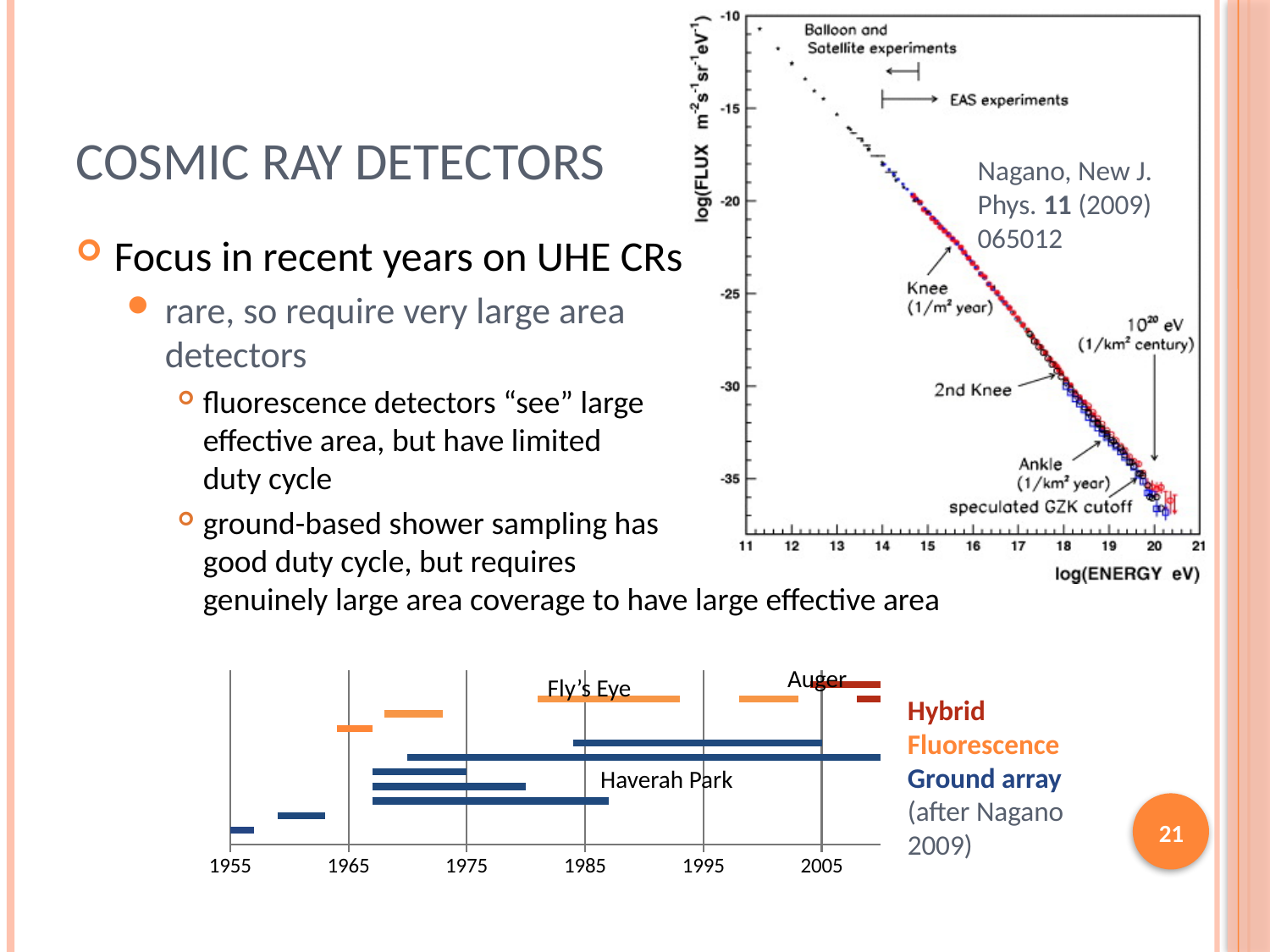
In the top-right chart, what is the label on the x axis? log(ENERGY eV) In the top-right chart, what flux rate is given in parentheses for the Ankle? 1/km² year In the bottom timeline chart, how many detector types does the legend list? 3 In the top-right chart, what feature is labelled at the highest-energy end of the spectrum? speculated GZK cutoff In the bottom timeline chart, which detector type is shown in orange? Fluorescence In the top-right chart, what is the lowest value shown on the y axis? -35 In the top-right chart, what flux rate is given in parentheses for the Knee? 1/m² year In the top-right chart, which experiments are indicated as covering the lower-energy part of the spectrum? Balloon and Satellite experiments In the bottom timeline chart, what kind of chart is used to show the detector operating periods? bar chart In the bottom timeline chart, what is the earliest year labelled on the x axis? 1955 In the top-right chart, does the flux rise or fall as log(ENERGY) increases? falls In the top-right chart, what flux rate is given in parentheses at 10^20 eV? 1/km² century